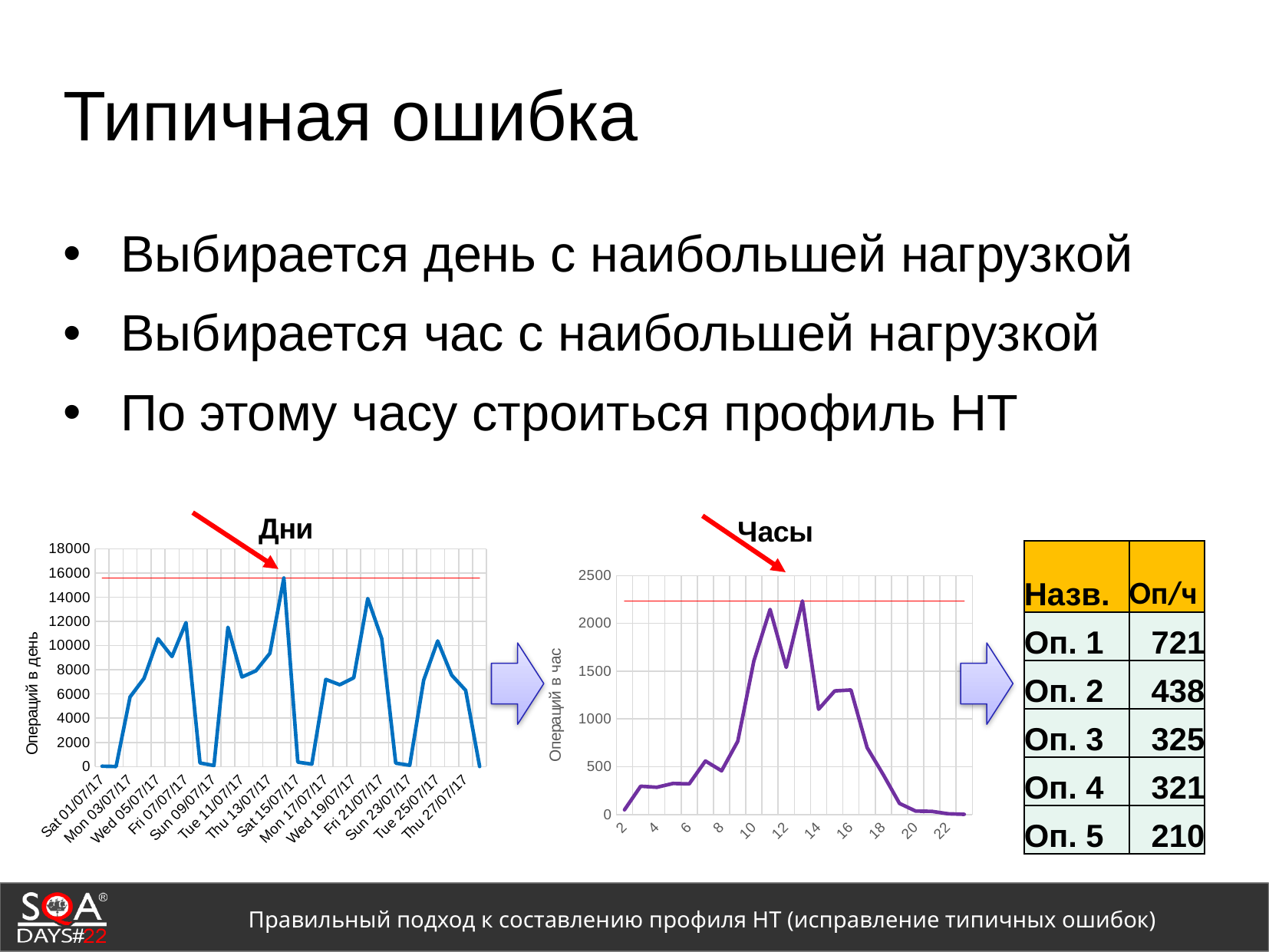
In the "Часы" chart, is the value at hour 16 greater or less than 1000? greater What kind of chart is the "Часы" chart? line chart In the "Часы" chart, is the highest value greater or less than 2000? greater In the "Дни" chart, is the value for Sat 15/07/17 greater or less than 14000? less In the "Часы" chart, which is larger: the value at hour 10 or the value at hour 18? hour 10 What kind of chart is the "Дни" chart? line chart In the "Дни" chart, which is larger: the value for Sat 15/07/17 or the value for Fri 21/07/17? Fri 21/07/17 In the "Часы" chart, do the values rise or fall from hour 14 to hour 22? fall What is the y-axis label of the "Дни" chart? Операций в день